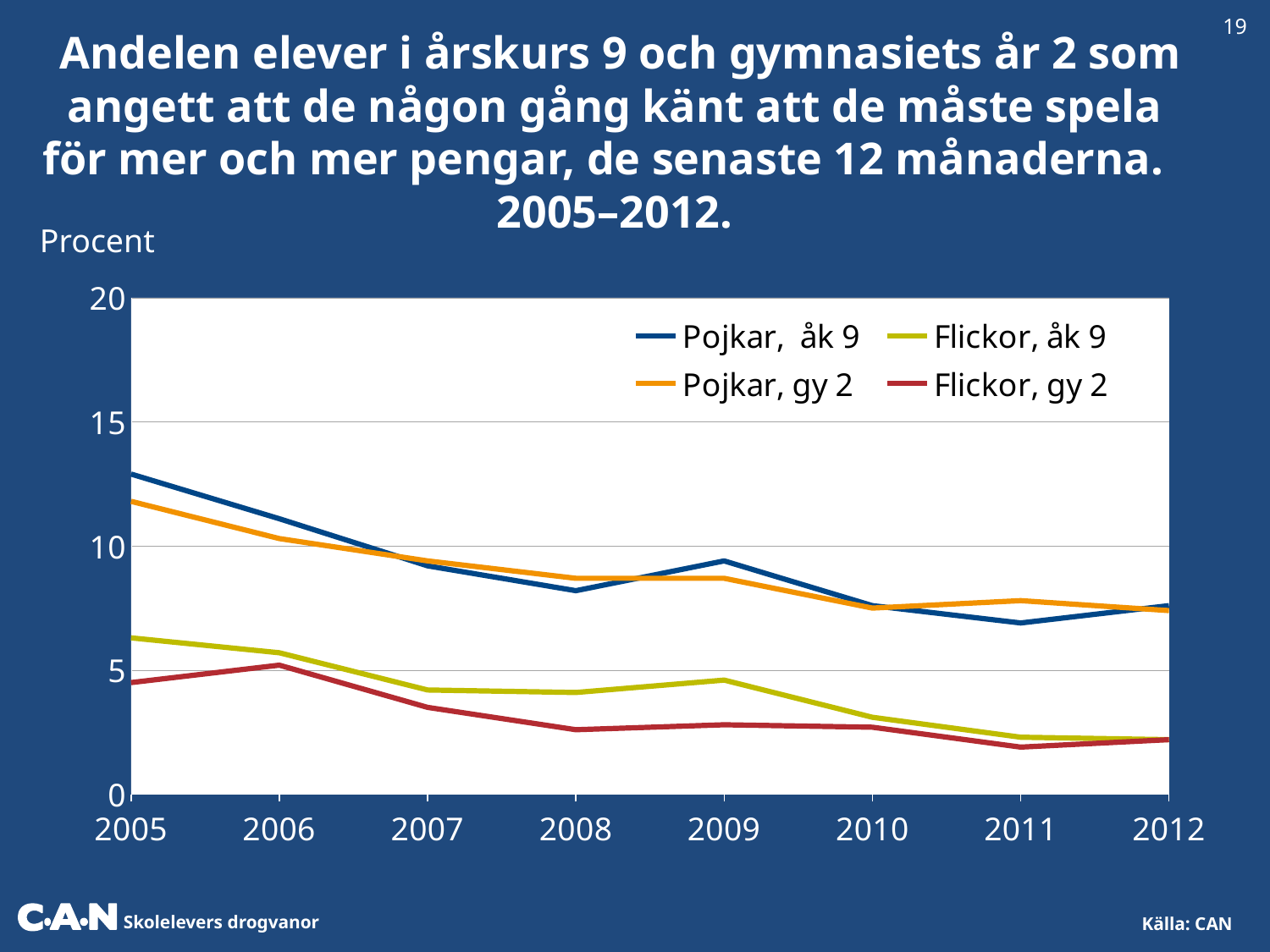
How many series does the legend list? 4 Is the value for Pojkar, åk 9 in 2005 greater or less than 10? greater In which year is the value for Pojkar, åk 9 the lowest? 2011 Does the value for Pojkar, åk 9 rise or fall from 2005 to 2012? fall What label is shown on the y axis of the chart? Procent What kind of chart is shown on the slide? line chart Is the value for Flickor, gy 2 in 2011 greater or less than 5? less Is the value for Pojkar, gy 2 in 2012 greater or less than 10? less In 2009, which is larger: Pojkar, åk 9 or Pojkar, gy 2? Pojkar, åk 9 In 2005, which is larger: Pojkar, åk 9 or Flickor, åk 9? Pojkar, åk 9 How many years are shown on the x axis? 8 Which series has the highest value in 2005? Pojkar, åk 9